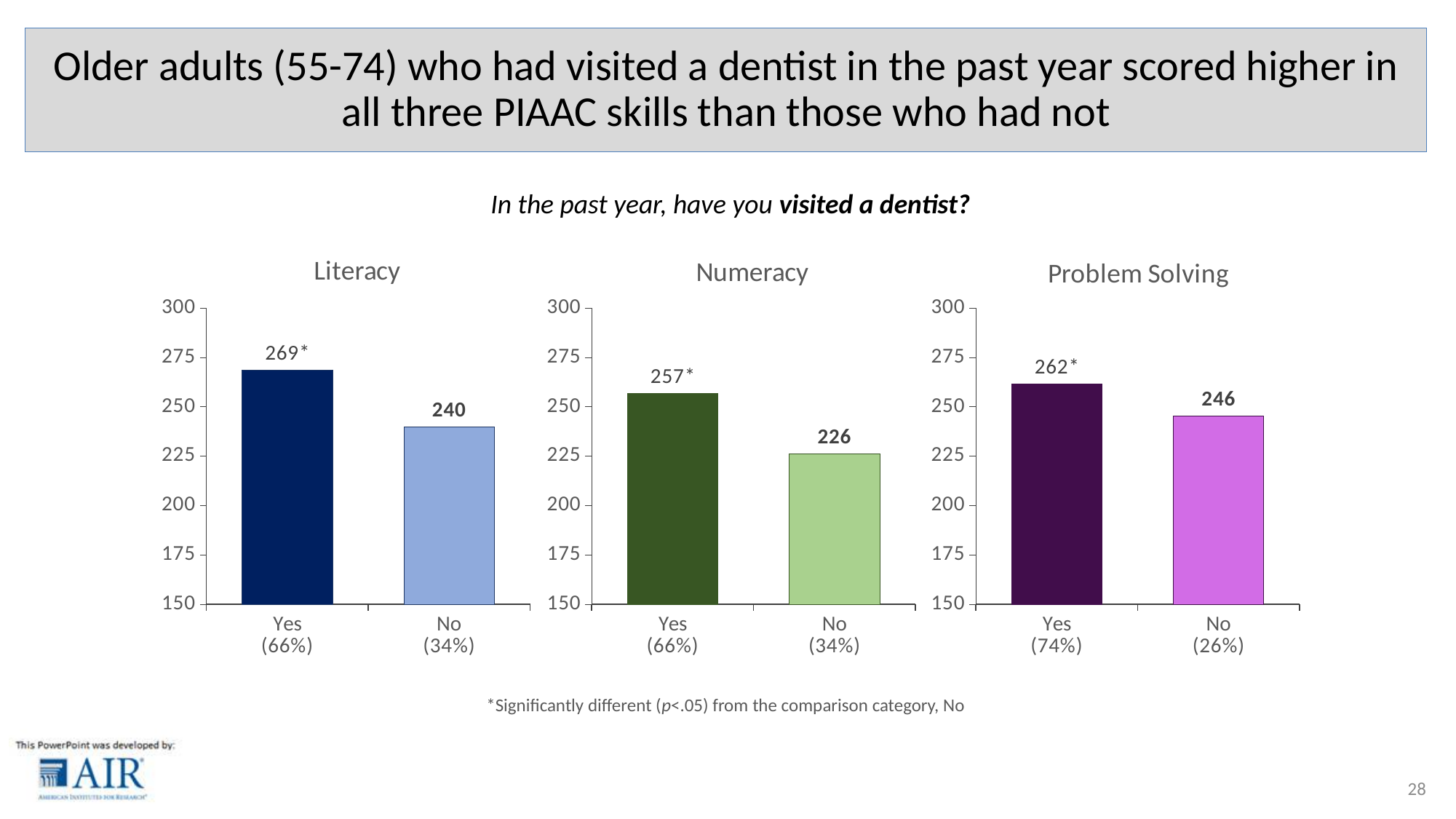
In the Problem Solving chart, what is the value for No (26%)? 246 In the Numeracy chart, which is larger, the value for Yes or the value for No? Yes How many bars are in the Problem Solving chart? 2 In the Numeracy chart, what is the value for Yes (66%)? 257 In the Problem Solving chart, what is the value for Yes (74%)? 262 What kind of chart is the Literacy chart? Bar chart In the Numeracy chart, what is the difference between the Yes and No values? 31 In the Problem Solving chart, which category has the lowest value? No (26%) In the Literacy chart, what is the difference between the Yes and No values? 29 In the Literacy chart, what is the value for Yes (66%)? 269 In the Literacy chart, what is the value for No (34%)? 240 In the Numeracy chart, what is the value for No (34%)? 226